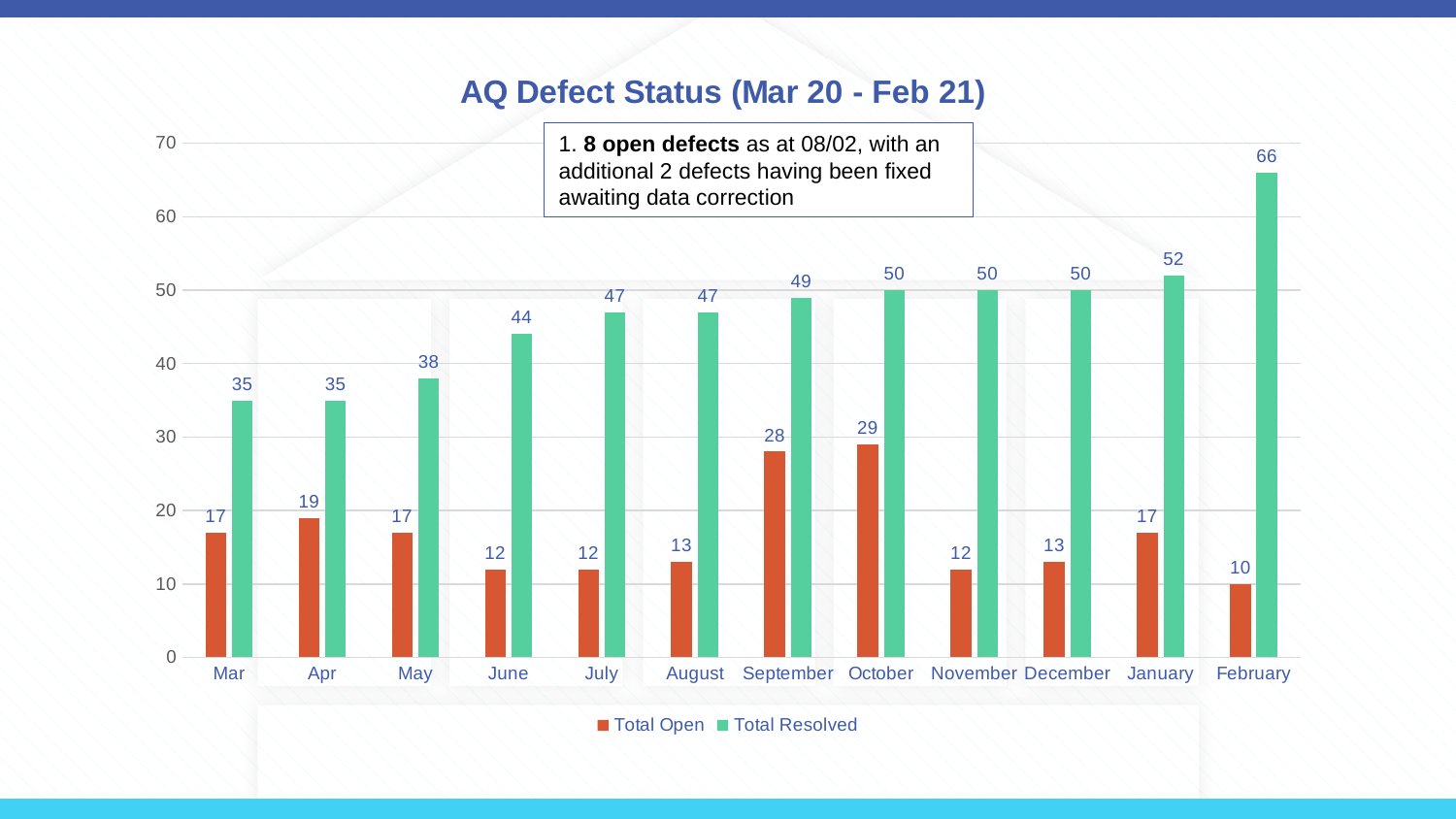
Is the Total Resolved value for June greater or less than 40? greater How many series does the legend list? 2 What is the Total Open value for October? 29 What is the Total Resolved value for February? 66 What kind of chart is shown on the slide? bar chart What is the difference between Total Resolved and Total Open in September? 21 What is the title of the chart? AQ Defect Status (Mar 20 - Feb 21) How many months are shown on the x axis? 12 Does the Total Resolved series generally rise or fall from Mar to February? rise Which month has the highest Total Resolved value? February Which month has the lowest Total Open value? February Is the Total Open value larger in September or in January? September